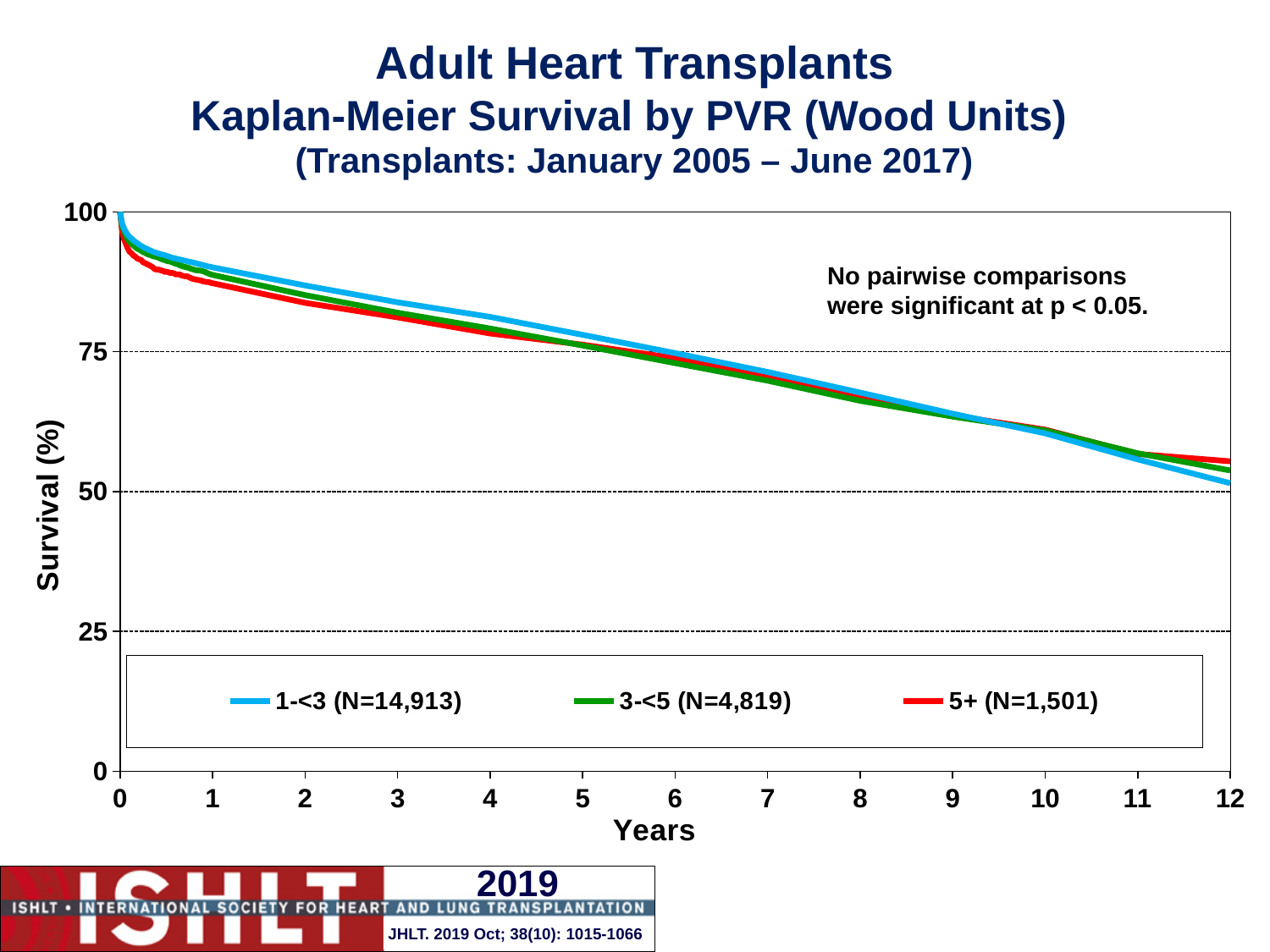
Is the survival value for the 1-<3 (N=14,913) group at 12 years greater or less than 75? less At 1 year, which group has higher survival: 1-<3 (N=14,913) or 5+ (N=1,501)? 1-<3 (N=14,913) Is the survival value for the 3-<5 (N=4,819) group at 6 years greater or less than 50? greater How many series does the legend list? 3 Do the survival curves rise or fall as years increase? fall What is the label of the y axis? Survival (%) At 1 year, which of the three groups has the lowest survival? 5+ (N=1,501) What is the N for the 1-<3 group shown in the legend? 14,913 Is the survival value for the 5+ (N=1,501) group at 12 years greater or less than 50? greater What kind of chart is shown on the slide? line chart